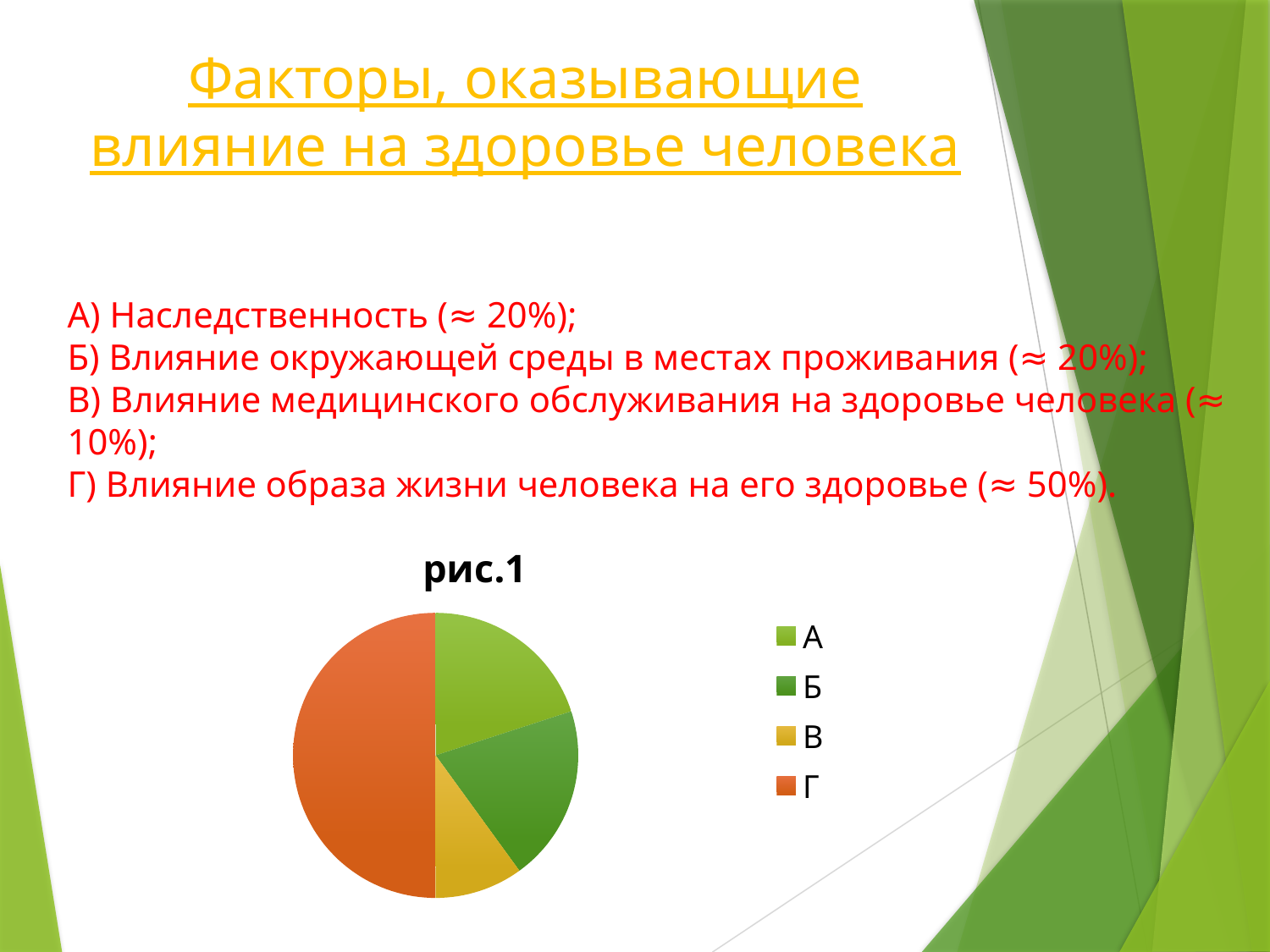
Which slice is larger, В or Г? Г Which slice is larger, Б or В? Б Which slice is larger, Г or А? Г How many entries does the chart legend list? 4 How many slices does the pie chart have? 4 Which category has the largest slice of the pie? Г What kind of chart is shown on the slide? pie chart Which category has the smallest slice of the pie? В What is the title of the chart? рис.1 What colour is the slice for category Г in the pie chart? orange